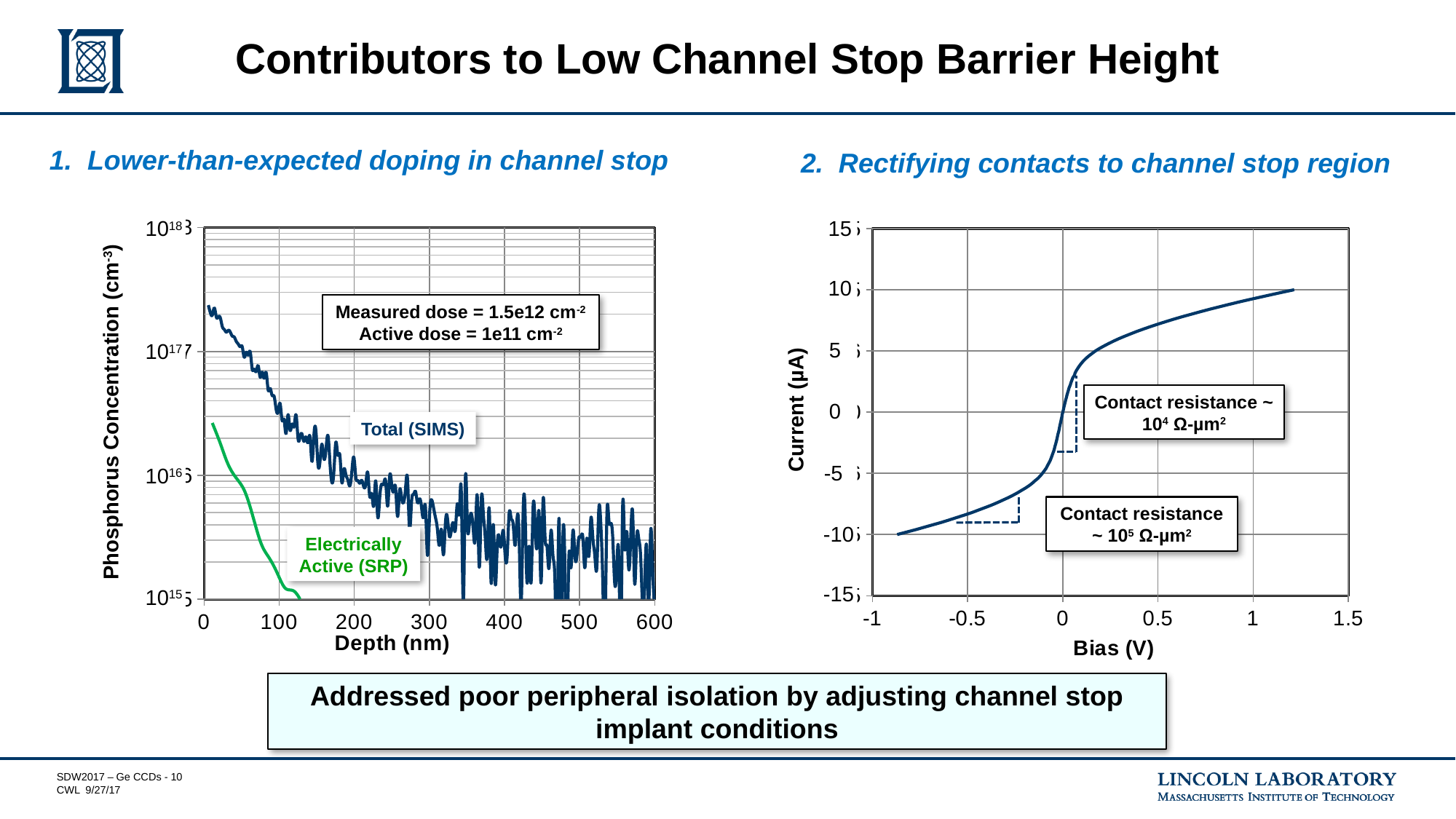
What kind of chart is the right chart (Current vs Bias)? line chart In the right chart, what is the label of the y axis? Current (µA) In the left chart, is the Total (SIMS) concentration near a depth of 0 nm greater or less than 10^17 cm^-3? greater In the left chart, does the Total (SIMS) phosphorus concentration rise or fall as depth increases? fall In the right chart, does the current rise or fall as the bias increases? rise What kind of chart is the left chart (Phosphorus Concentration vs Depth)? line chart In the right chart, is the current at a bias of 1 V greater or less than 5 µA? greater In the left chart, what is the label of the x axis? Depth (nm) In the left chart, how many data series are plotted? 2 In the right chart, is the current at a bias of -0.5 V greater or less than -5 µA? less In the left chart, at a depth of 50 nm, which series has the higher concentration, Total (SIMS) or Electrically Active (SRP)? Total (SIMS)